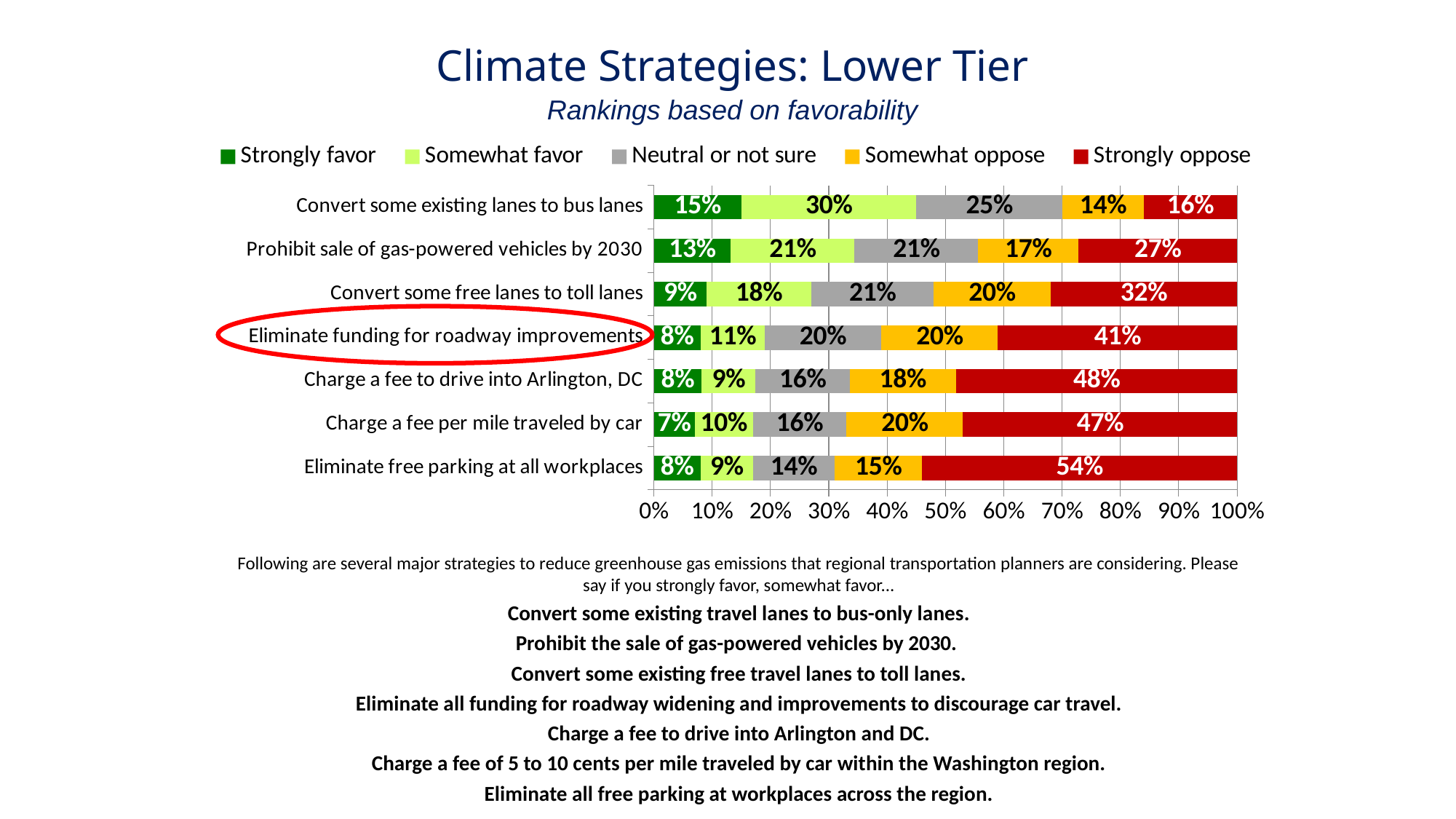
Which strategy has the lowest 'Strongly oppose' percentage? Convert some existing lanes to bus lanes What percentage strongly oppose eliminating free parking at all workplaces? 54% How many series does the legend list? 5 Which strategy has the highest 'Strongly oppose' percentage? Eliminate free parking at all workplaces Which strategy is circled in red on the chart? Eliminate funding for roadway improvements What kind of chart is shown on the slide? Stacked bar chart What percentage strongly favor converting some existing lanes to bus lanes? 15% How many strategies are shown in the chart? 7 What percentage somewhat oppose converting some free lanes to toll lanes? 20% What percentage are neutral or not sure about prohibiting the sale of gas-powered vehicles by 2030? 21% What is the difference between the 'Strongly oppose' percentages for 'Charge a fee to drive into Arlington, DC' and 'Eliminate funding for roadway improvements'? 7% Which has a larger 'Somewhat favor' percentage: 'Convert some existing lanes to bus lanes' or 'Convert some free lanes to toll lanes'? Convert some existing lanes to bus lanes